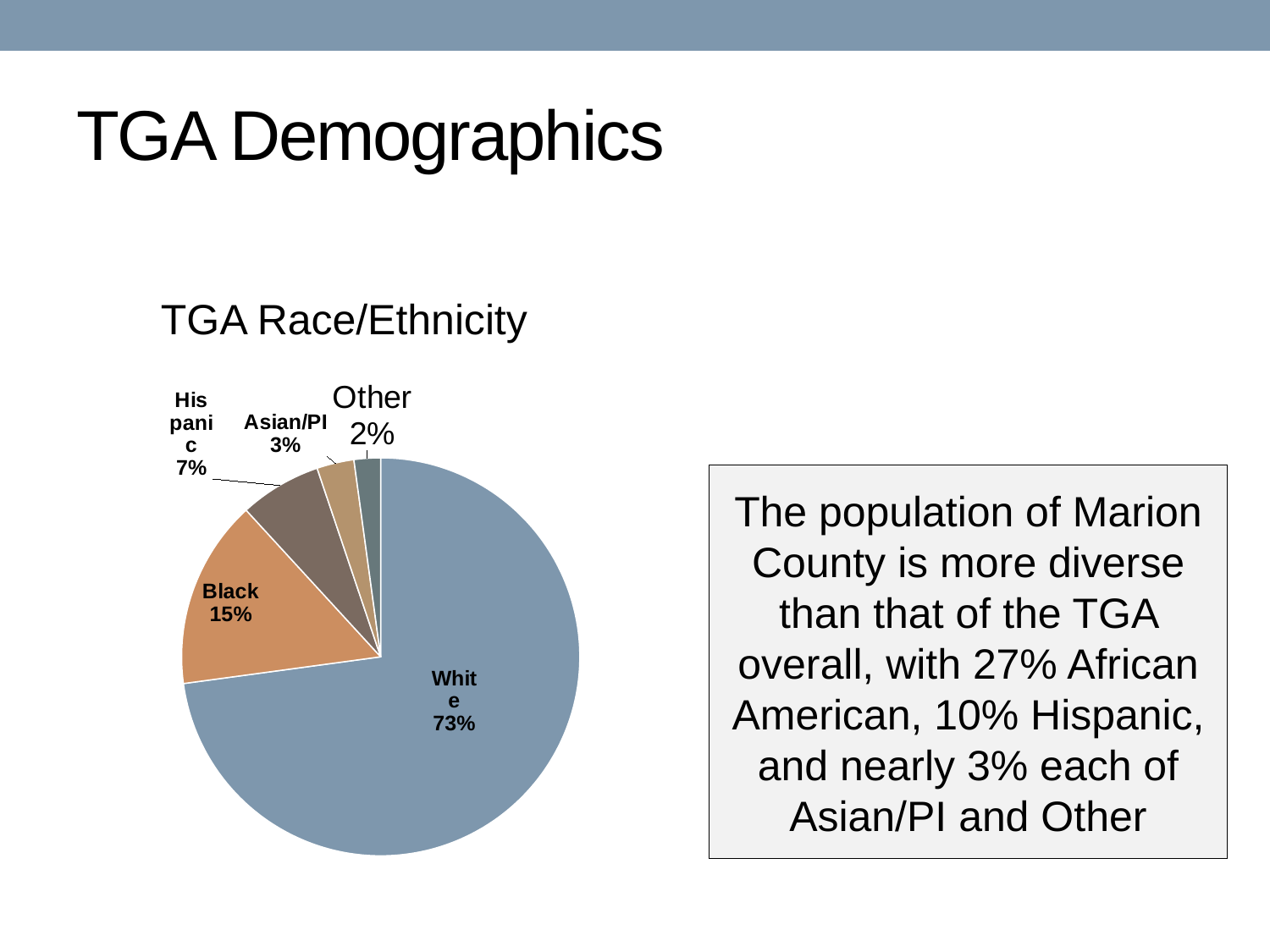
What percentage does the Asian/PI slice represent? 3% What is the Hispanic share shown in the TGA Race/Ethnicity chart? 7% Which category has the largest slice in the TGA Race/Ethnicity pie chart? White What is the difference in percentage points between the White and Black slices? 58 Which category has the smallest slice in the pie chart? Other How many categories are shown in the TGA Race/Ethnicity pie chart? 5 What percentage of the TGA population is Black according to the pie chart? 15% What is the value of the Other slice in the pie chart? 2% Which is larger in the pie chart, the Black slice or the Hispanic slice? Black What share of the TGA Race/Ethnicity pie is White? 73% What type of chart is used to show TGA Race/Ethnicity? Pie chart What is the title of the chart on the slide? TGA Race/Ethnicity